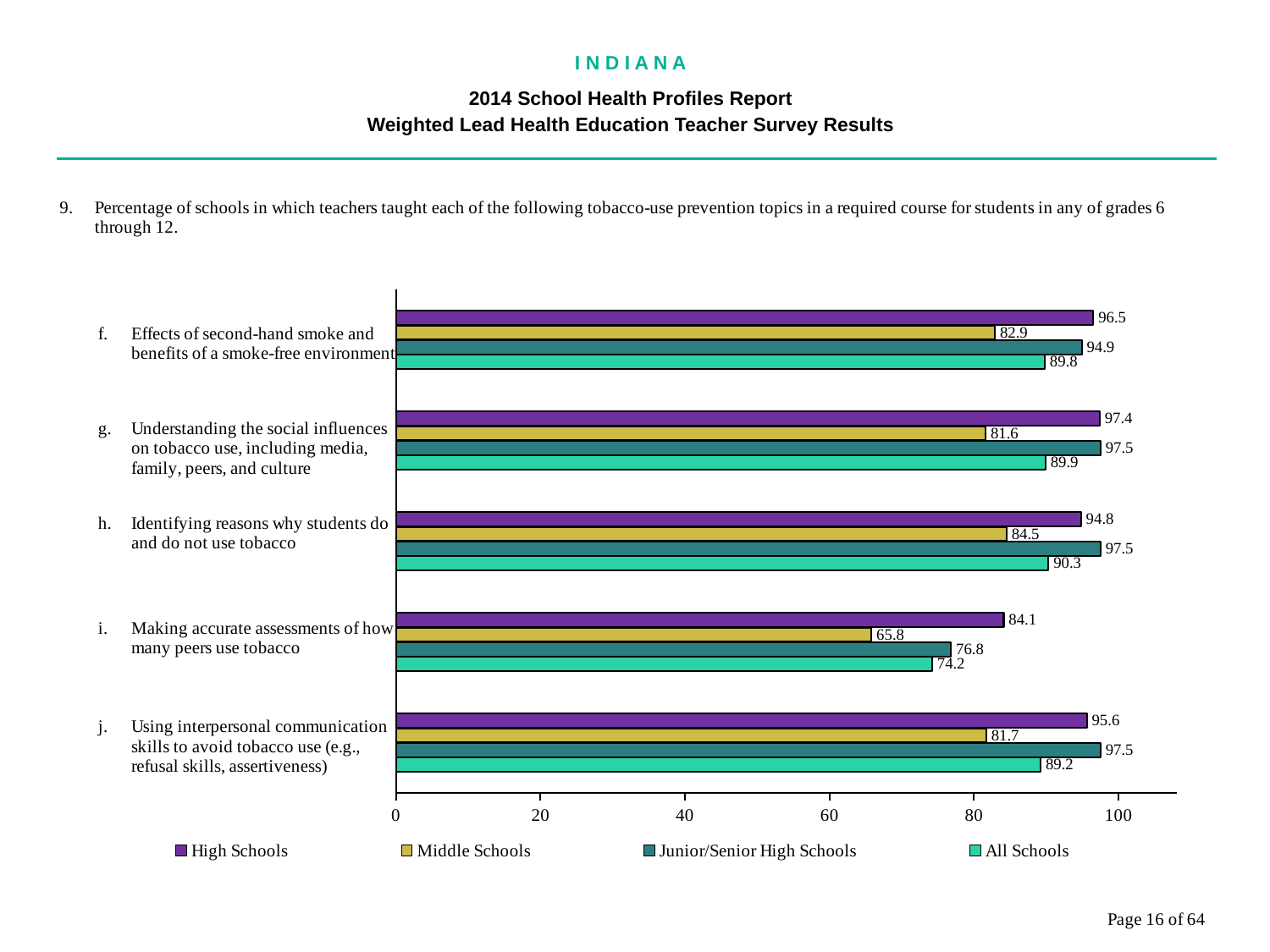
What is the All Schools value for topic j, using interpersonal communication skills to avoid tobacco use? 89.2 What is the value for Middle Schools for topic i, making accurate assessments of how many peers use tobacco? 65.8 How many tobacco-use prevention topics are shown on the chart? 5 What kind of chart is shown on the slide? bar chart How many series does the legend list? 4 For topic i, is the value for High Schools or Junior/Senior High Schools larger? High Schools What is the difference between the High Schools and Middle Schools values for topic g, understanding the social influences on tobacco use? 15.8 Which series is shown in purple in the legend? High Schools Is the Middle Schools value for topic i greater or less than 80? less Which school type has the highest value for topic h, identifying reasons why students do and do not use tobacco? Junior/Senior High Schools What is the value for High Schools for topic f, effects of second-hand smoke and benefits of a smoke-free environment? 96.5 Which topic has the lowest All Schools value? i. Making accurate assessments of how many peers use tobacco